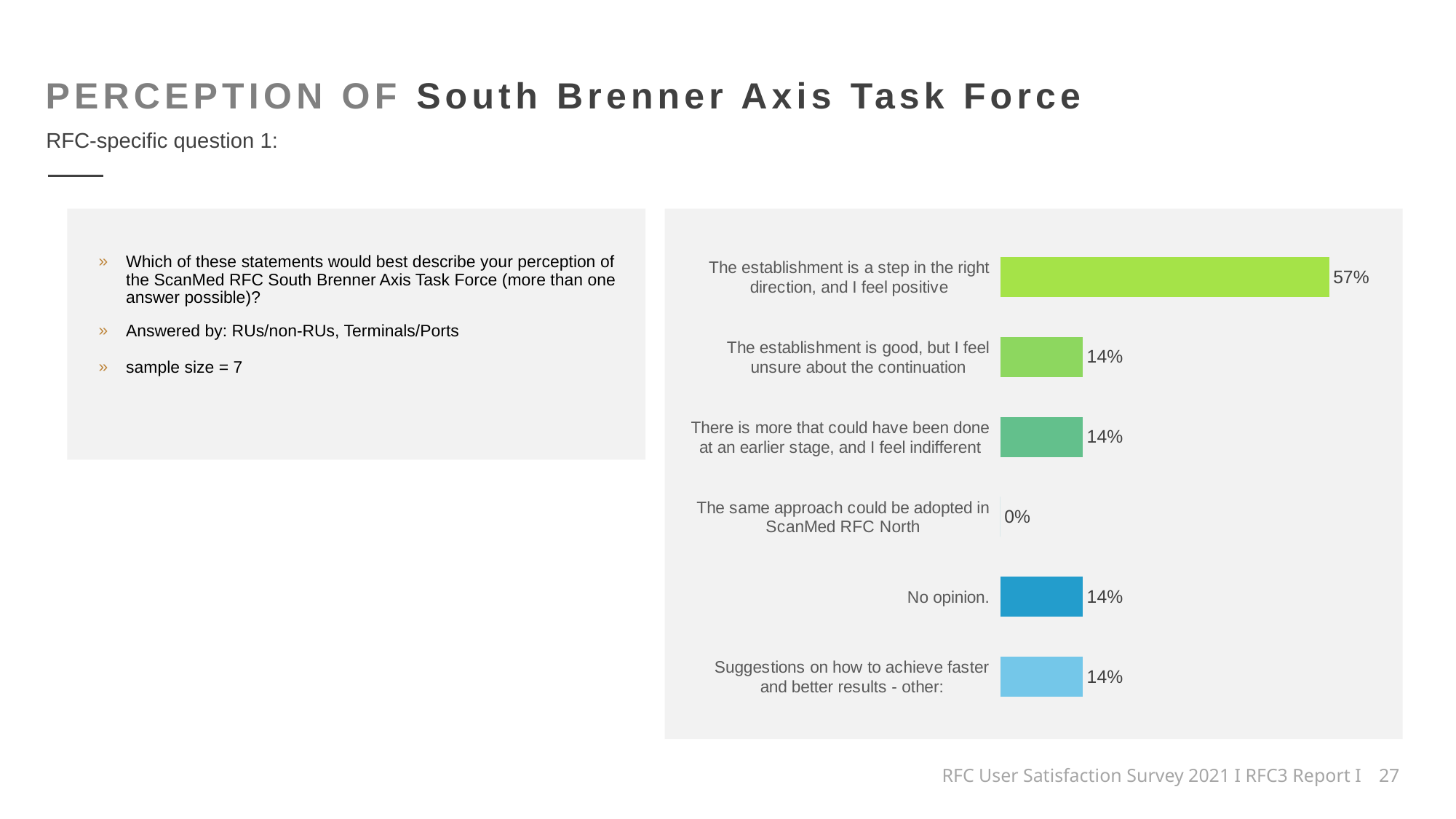
What percentage of respondents selected 'No opinion.'? 14% Which statement received the lowest percentage of responses? The same approach could be adopted in ScanMed RFC North How many statements received exactly 14% of responses? 4 What percentage of respondents said the establishment is good but they feel unsure about the continuation? 14% What type of chart is shown on the slide? Bar chart What percentage of respondents said the same approach could be adopted in ScanMed RFC North? 0% What is the sample size stated on the slide for this question? 7 Which statement received the highest percentage of responses? The establishment is a step in the right direction, and I feel positive What is the difference in percentage points between 'The establishment is a step in the right direction, and I feel positive' and 'No opinion.'? 43 percentage points What percentage of respondents said the establishment is a step in the right direction and they feel positive? 57% Which has a larger value: 'The establishment is a step in the right direction, and I feel positive' or 'There is more that could have been done at an earlier stage, and I feel indifferent'? The establishment is a step in the right direction, and I feel positive How many statement categories are shown in the chart? 6